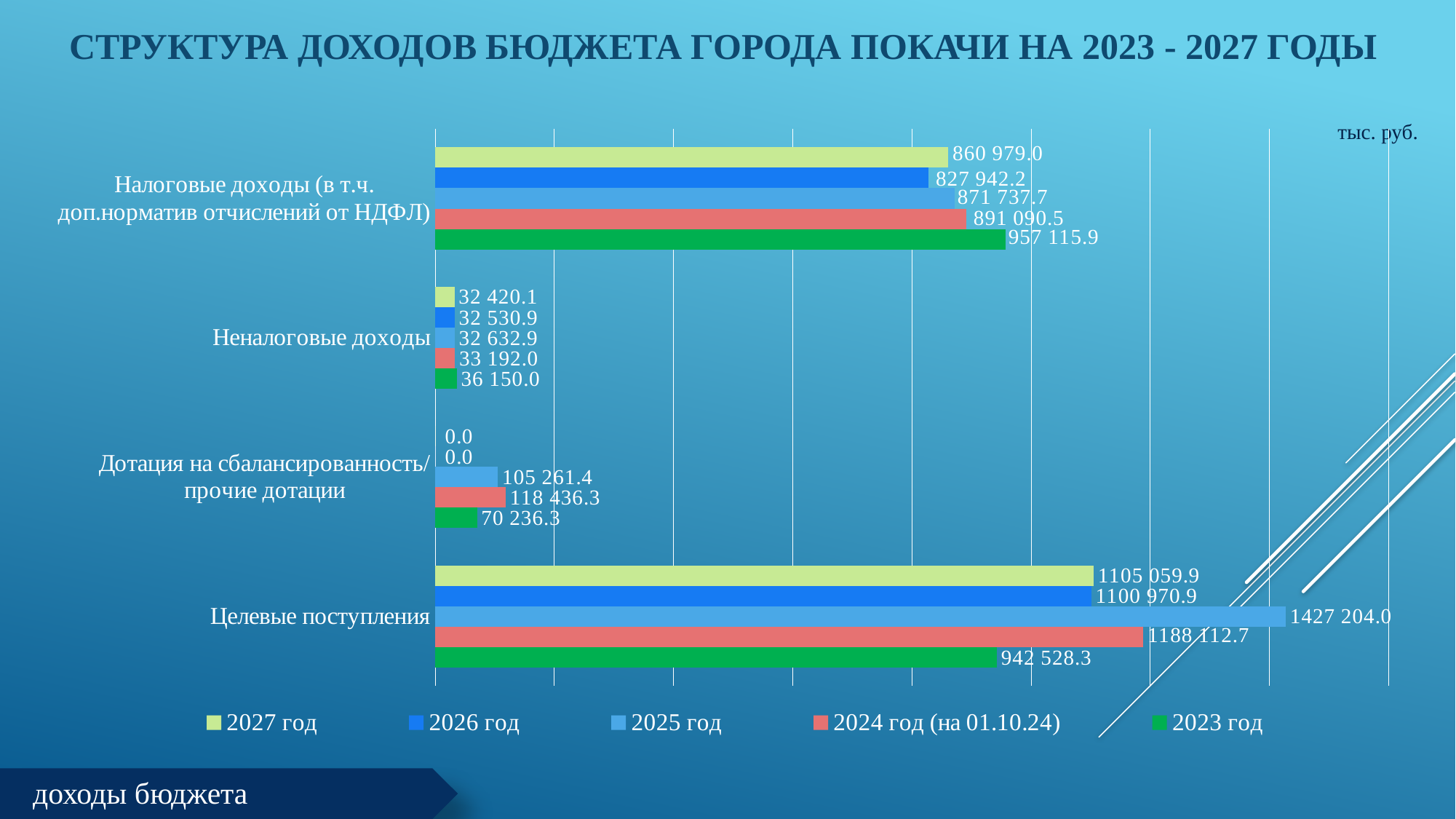
What is the value for Налоговые доходы in 2023 год? 957 115.9 How many series does the legend list? 5 What unit of measurement is indicated on the chart? тыс. руб. Which is larger for Дотация на сбалансированность/прочие дотации: the 2024 год (на 01.10.24) value or the 2023 год value? 2024 год (на 01.10.24) What type of chart is shown on the slide? bar chart Which year has the lowest value for Неналоговые доходы? 2027 год What is the value for Дотация на сбалансированность/прочие дотации in 2027 год? 0.0 What is the difference between the 2023 год and 2027 год values for Налоговые доходы? 96 136.9 How many categories are shown on the chart? 4 Which year has the highest value for Целевые поступления? 2025 год What is the value for Неналоговые доходы in 2024 год (на 01.10.24)? 33 192.0 What is the value for Целевые поступления in 2025 год? 1427 204.0